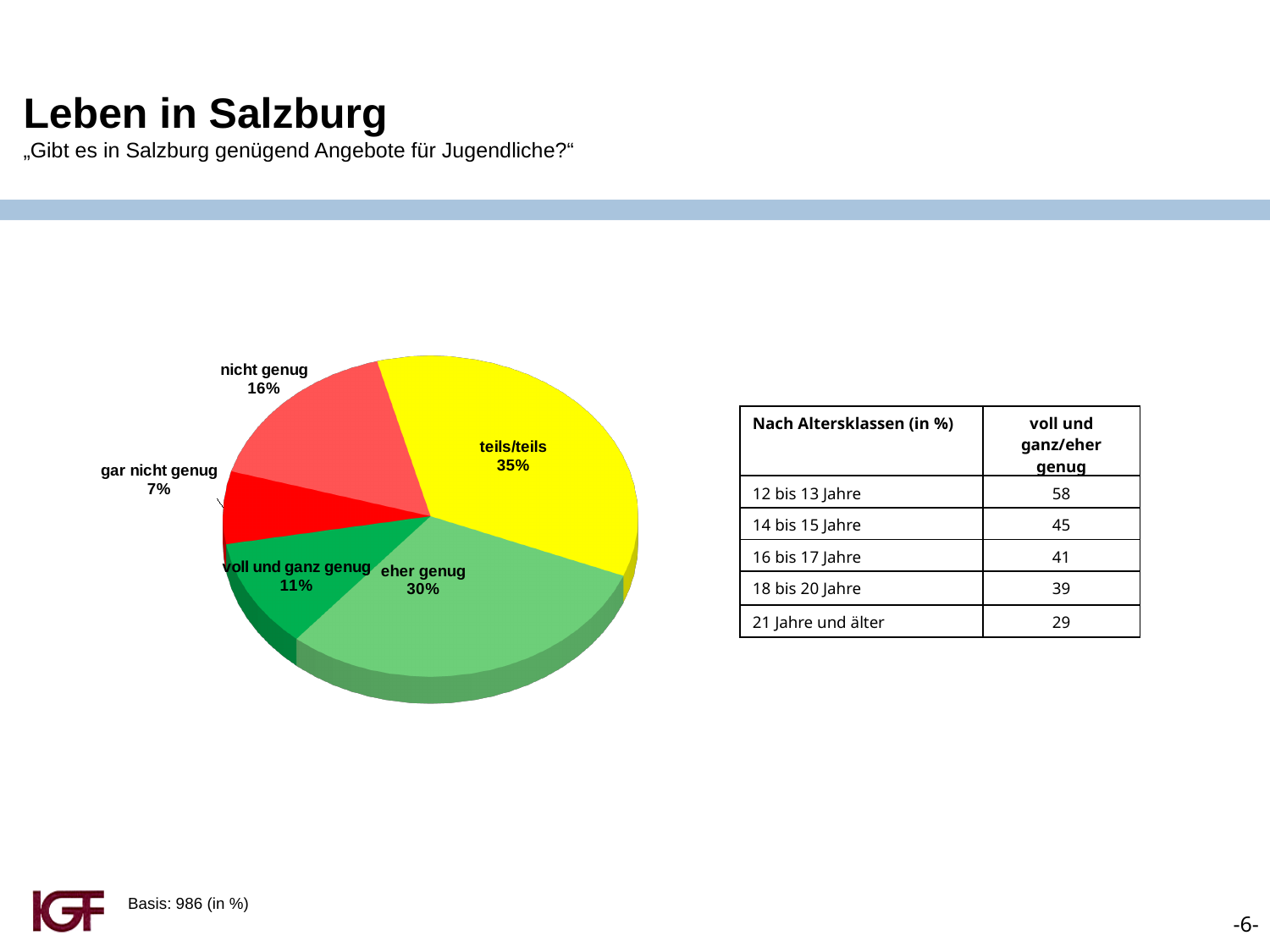
Which slice of the pie chart is the largest? teils/teils What percentage of the pie chart is labelled "eher genug"? 30% What is the combined share of the "voll und ganz genug" and "eher genug" slices? 41% What colour is the "teils/teils" slice in the pie chart? yellow What percentage of the pie chart is labelled "gar nicht genug"? 7% Which slice of the pie chart is the smallest? gar nicht genug How many slices does the pie chart have? 5 What percentage of the pie chart is labelled "teils/teils"? 35% What type of chart is shown on the slide? pie chart What percentage of the pie chart is labelled "voll und ganz genug"? 11% Which slice is larger in the pie chart: "eher genug" or "nicht genug"? eher genug What is the difference in percentage points between the "nicht genug" and "gar nicht genug" slices? 9